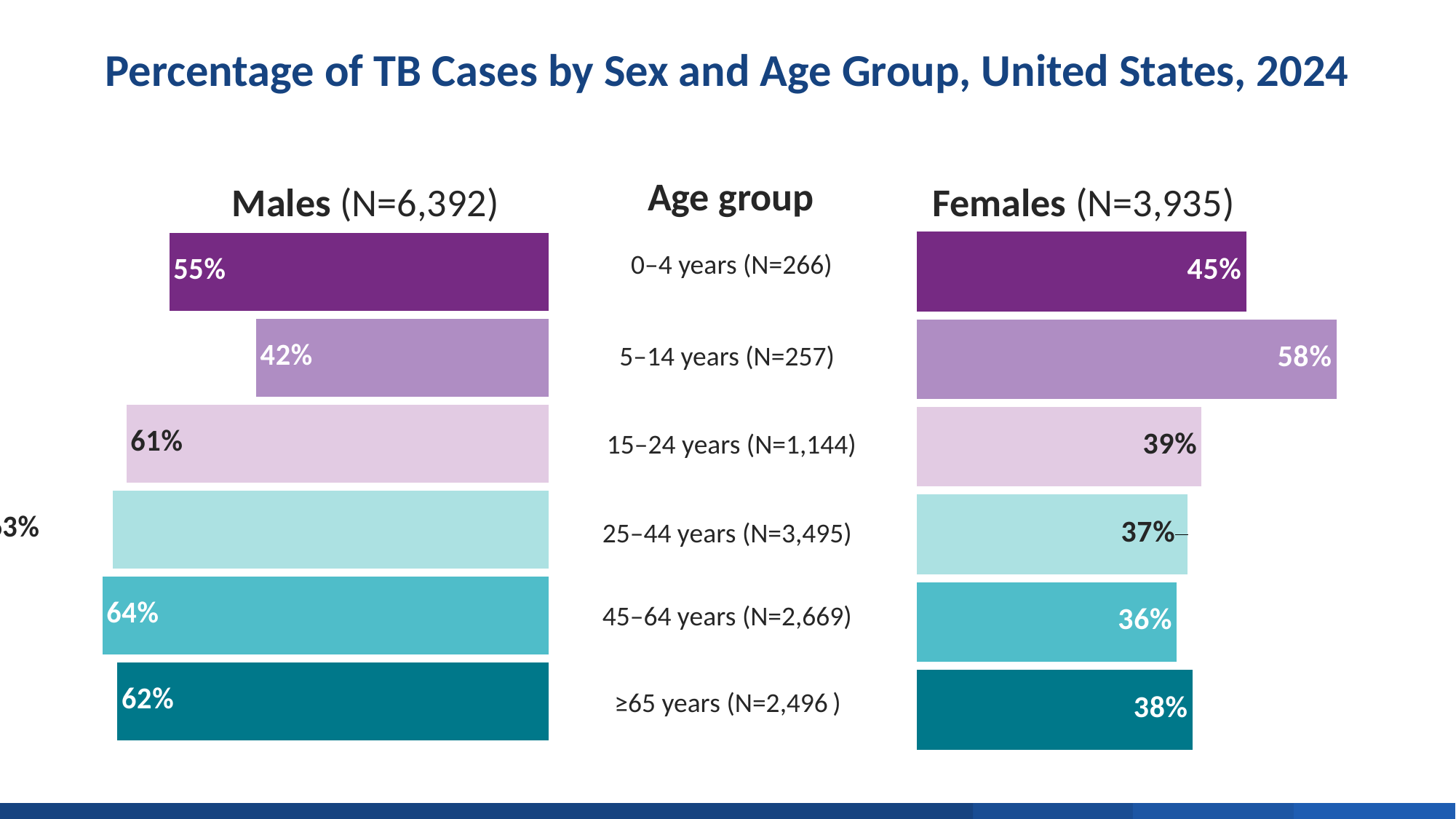
What percentage of TB cases among 45–64 years were female? 36% What is the difference between the male and female percentages for the 15–24 years age group? 22% What is the N for the 25–44 years age group? 3,495 What type of chart is shown on the slide? Bar chart What percentage of TB cases among ≥65 years were male? 62% What is the total number of male TB cases (N) shown in the chart heading? 6,392 For the 5–14 years age group, is the male or female percentage larger? Female Which age group has the lowest female percentage of TB cases? 45–64 years How many age groups are shown in the chart? 6 Which age group has the highest female percentage of TB cases? 5–14 years What percentage of TB cases among 0–4 years were male? 55% What percentage of TB cases among 5–14 years were female? 58%